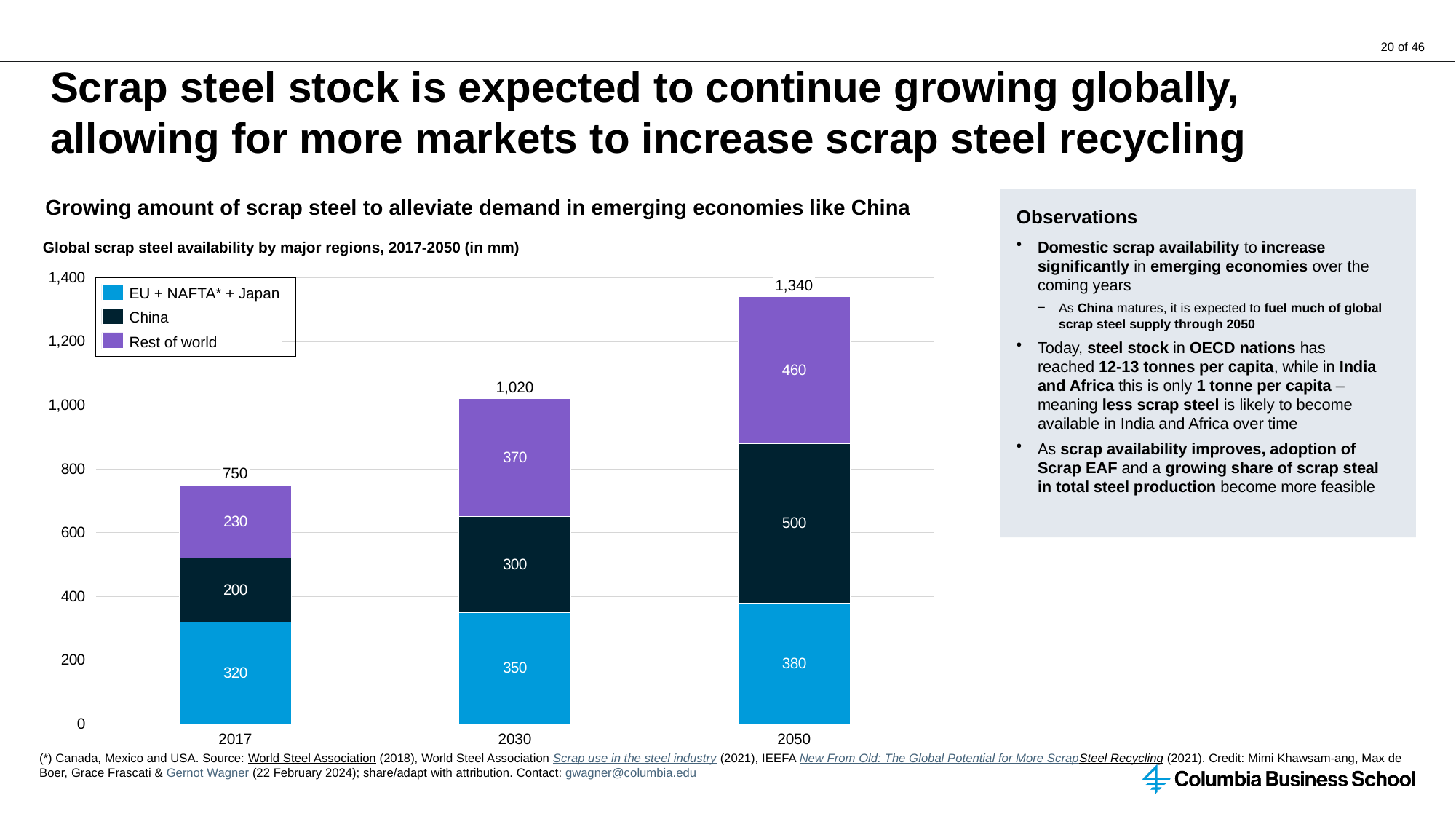
What is the total of the stacked bar for 2050? 1,340 How many series does the legend list? 3 What kind of chart is shown? Stacked bar chart How many years are shown on the x axis? 3 Which year has the highest total scrap steel availability? 2050 Do the total values rise or fall from 2017 to 2050? Rise Which year has the lowest total scrap steel availability? 2017 What is the difference between the China values for 2050 and 2017? 300 What is the value for China in 2030? 300 What is the value for Rest of world in 2050? 460 What is the value for EU + NAFTA* + Japan in 2017? 320 Which is larger in 2030: the value for China or the value for Rest of world? Rest of world